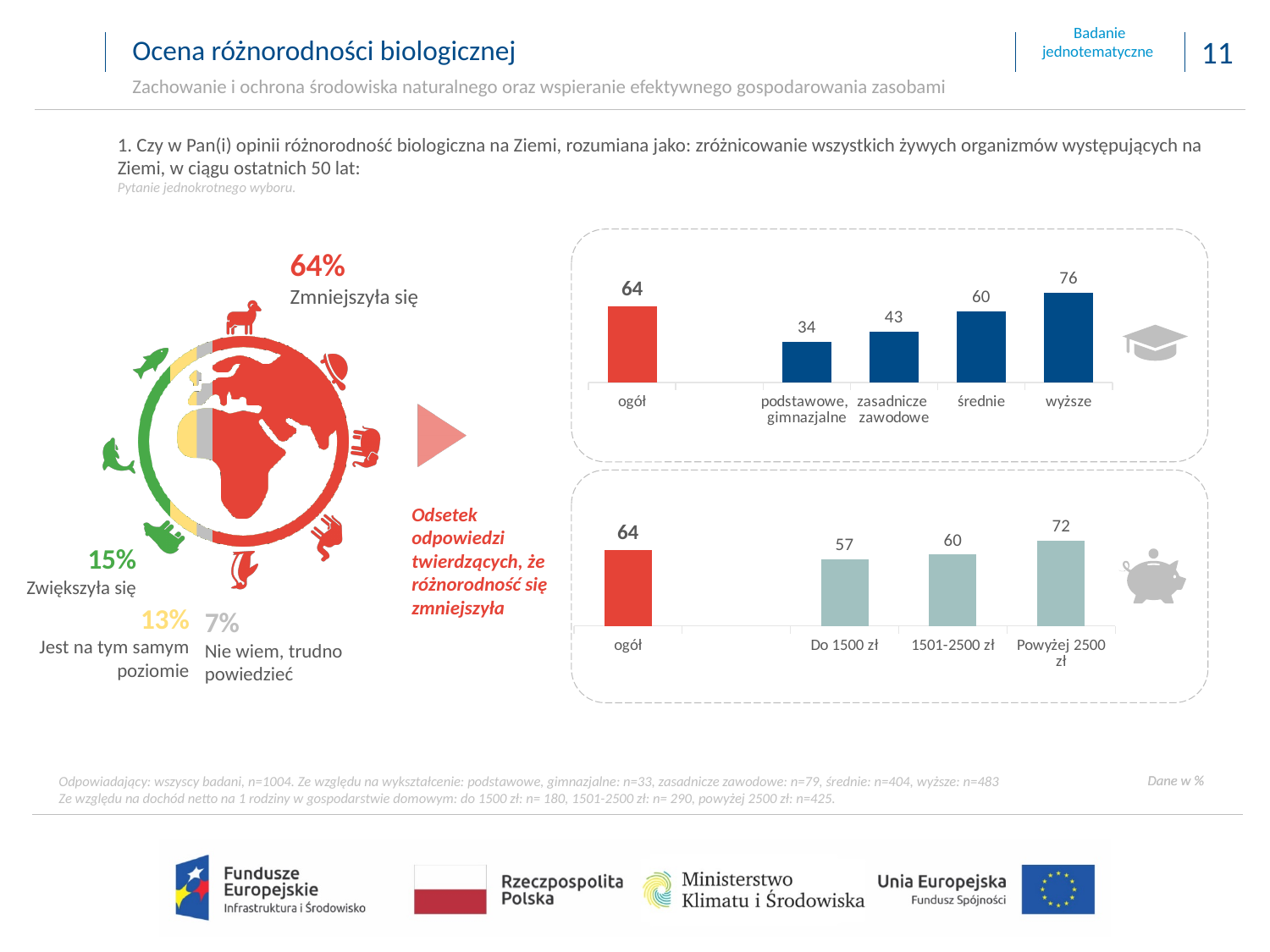
In the upper right bar chart (by education), how many bars are shown? 5 In the upper right bar chart (by education), which education category has the lowest value? podstawowe, gimnazjalne In the lower right bar chart (by income), what is the value for 'Powyżej 2500 zł'? 72 In the lower right bar chart (by income), is the value for 'Do 1500 zł' larger or smaller than the value for '1501-2500 zł'? smaller In the lower right bar chart (by income), what is the difference between 'ogół' and 'Do 1500 zł'? 7 In the upper right bar chart (by education), what is the difference between 'wyższe' and 'zasadnicze zawodowe'? 33 In the lower right bar chart (by income), do the values rise or fall from 'Do 1500 zł' to 'Powyżej 2500 zł'? rise In the upper right bar chart (by education), what is the value for 'podstawowe, gimnazjalne'? 34 What kind of chart is shown in the upper right panel of the slide? bar chart In the globe infographic on the left, what percentage of respondents answered 'Zmniejszyła się'? 64% In the lower right bar chart (by income), which income category has the highest value? Powyżej 2500 zł In the upper right bar chart (by education), what is the value for 'wyższe'? 76